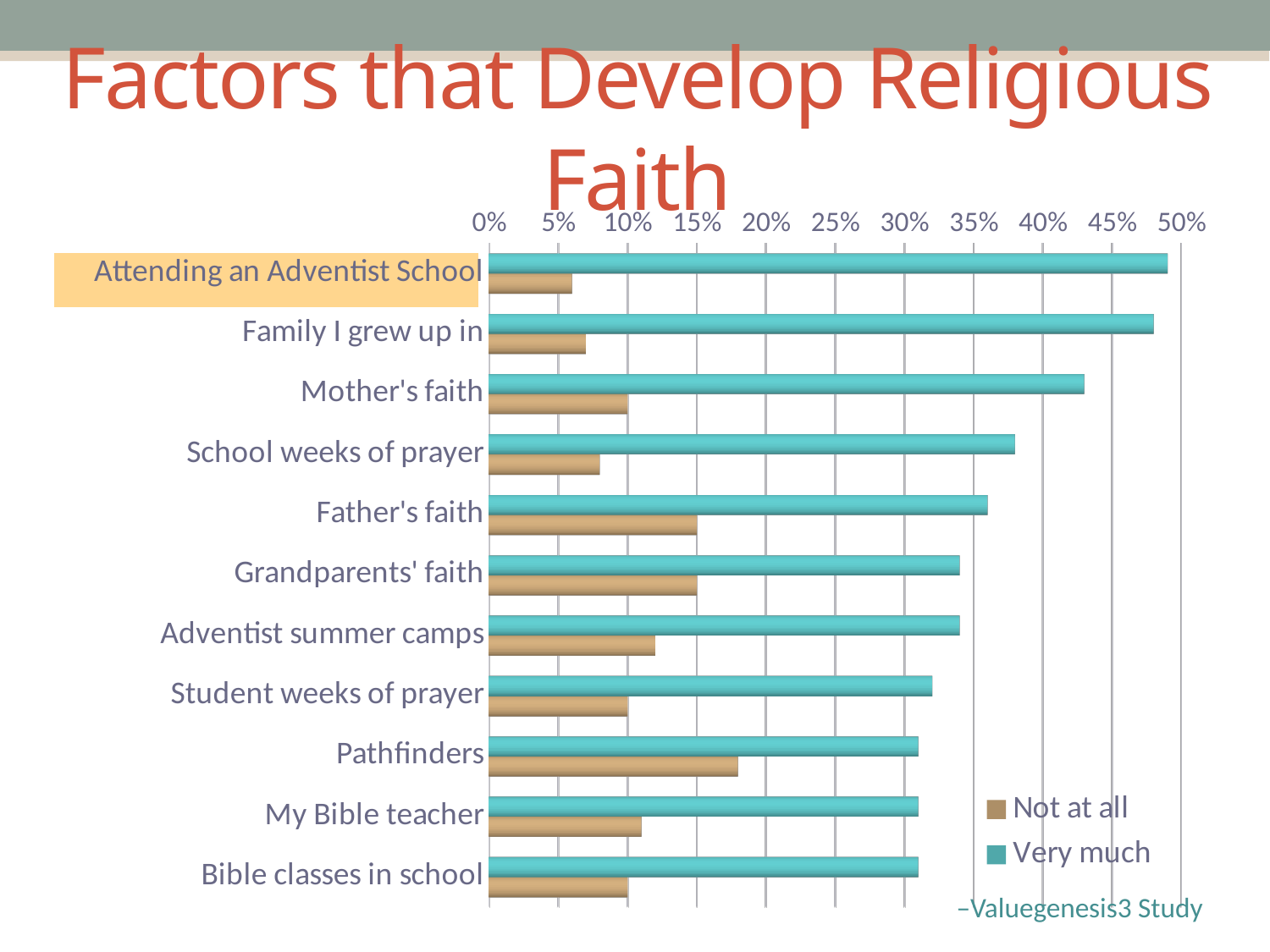
Is the 'Not at all' value for Attending an Adventist School greater or less than 10%? less Is the 'Very much' value for Father's faith greater or less than 30%? greater How many series does the legend list? 2 Which has the larger 'Not at all' value, Father's faith or Mother's faith? Father's faith Which category has the highest 'Not at all' value? Pathfinders What kind of chart is shown on the slide? Bar chart Is the 'Very much' value for Mother's faith greater or less than 40%? greater Which has the larger 'Very much' value, Mother's faith or Father's faith? Mother's faith How many categories (factors) are plotted on the chart? 11 Which series is shown in teal on the chart? Very much